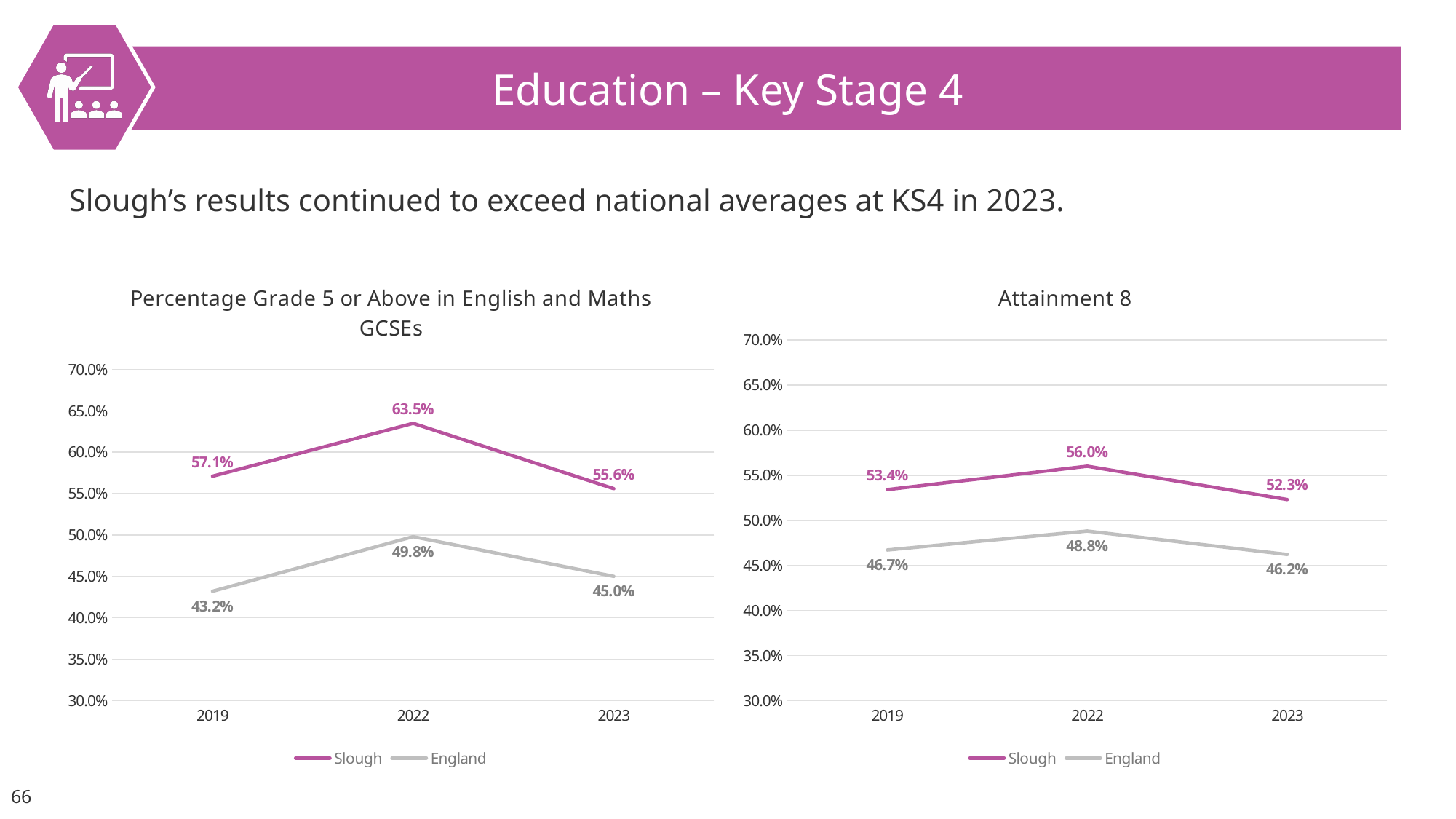
In the 'Attainment 8' chart, what is the value for Slough in 2023? 52.3% How many series does the legend of the 'Attainment 8' chart list? 2 In the 'Attainment 8' chart, in which year is the England value lowest? 2023 In the 'Percentage Grade 5 or Above in English and Maths GCSEs' chart, how many years are shown on the x axis? 3 In the 'Percentage Grade 5 or Above in English and Maths GCSEs' chart, what is the value for Slough in 2022? 63.5% In the 'Percentage Grade 5 or Above in English and Maths GCSEs' chart, what is the difference between the Slough and England values in 2023? 10.6% In the 'Attainment 8' chart, which series has the higher value in 2019, Slough or England? Slough In the 'Attainment 8' chart, what is the difference between the Slough values in 2022 and 2019? 2.6% In the 'Attainment 8' chart, what is the value for England in 2022? 48.8% What type of chart is the 'Attainment 8' chart? Line chart In the 'Percentage Grade 5 or Above in English and Maths GCSEs' chart, what is the value for England in 2019? 43.2% In the 'Percentage Grade 5 or Above in English and Maths GCSEs' chart, in which year is the Slough value highest? 2022